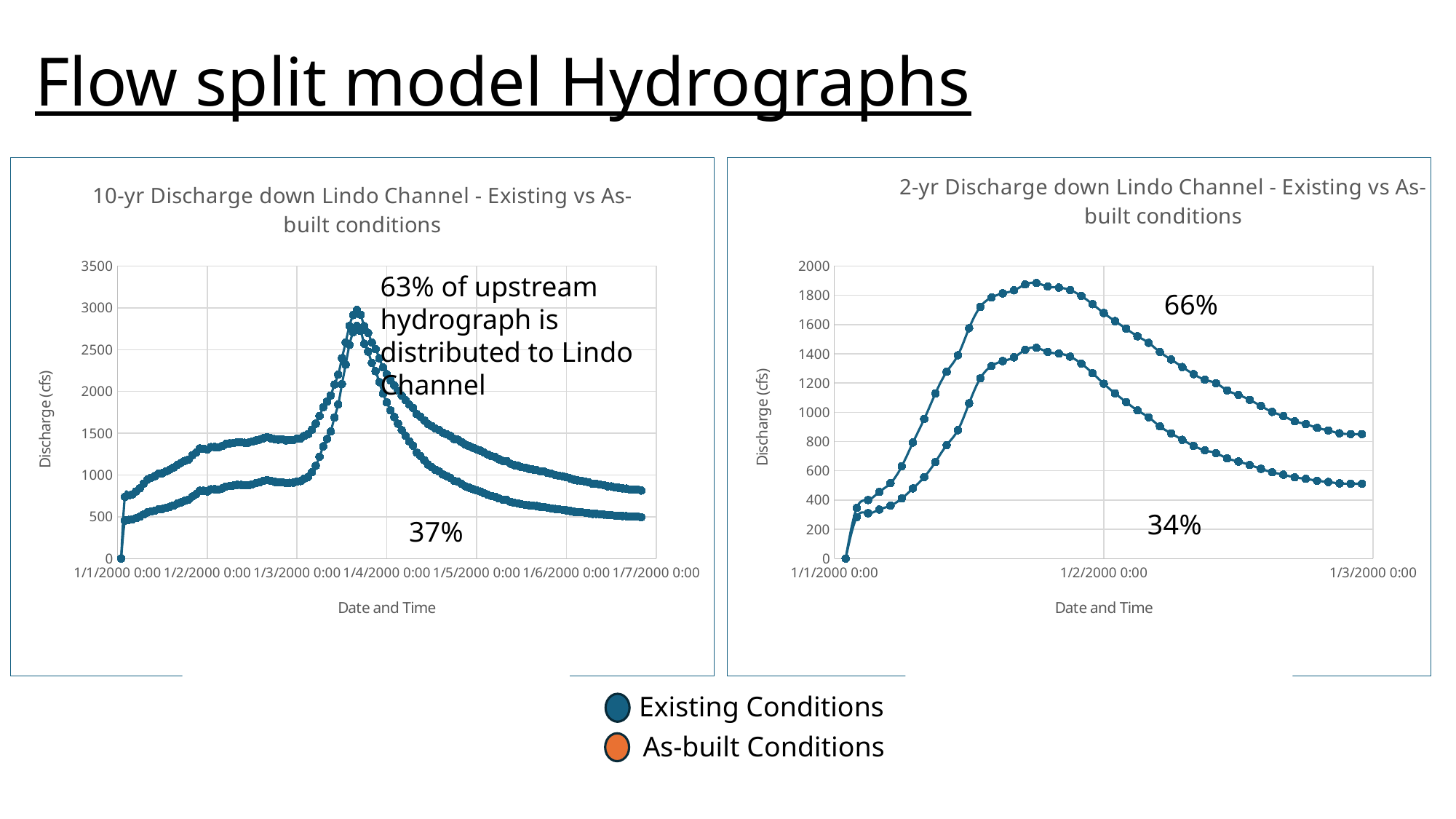
In the right chart (2-yr), is the value of the higher line at 1/3/2000 0:00 greater or less than 800? greater In the right chart (2-yr), is the peak value of the lower line greater or less than 1500? less What is the label on the vertical axis of the left chart? Discharge (cfs) What is the title of the right chart? 2-yr Discharge down Lindo Channel - Existing vs As-built conditions In the right chart (2-yr), do the values rise or fall between the peak and 1/3/2000 0:00? fall In the left chart (10-yr), is the peak value of the higher line greater or less than 2500? greater What kind of chart is the left chart, '10-yr Discharge down Lindo Channel - Existing vs As-built conditions'? Line chart Which chart has the higher peak discharge, the left 10-yr chart or the right 2-yr chart? The left 10-yr chart How many series does the legend below the charts list? 2